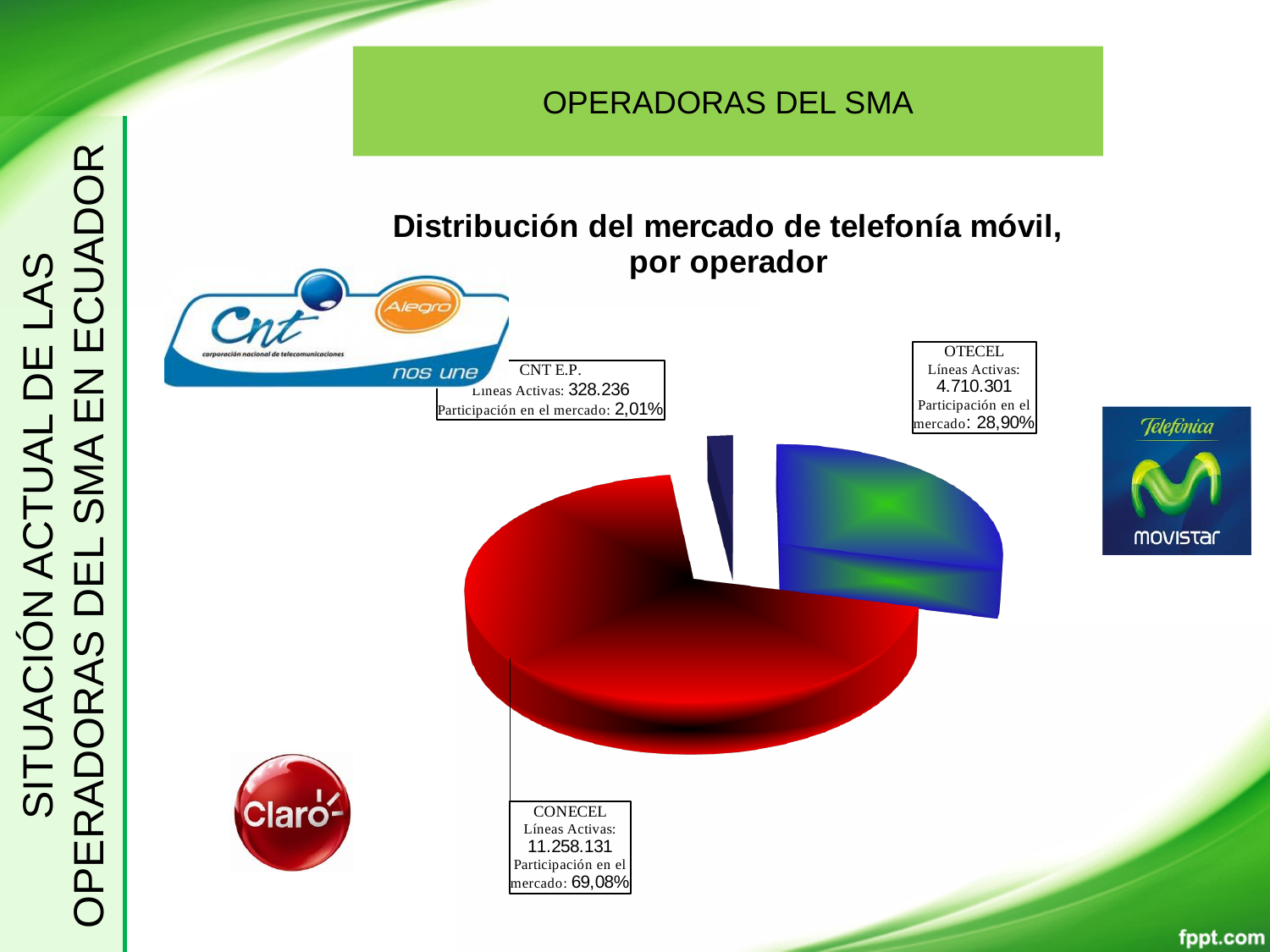
Which operator has the smallest share of the pie? CNT E.P. What is the title of the pie chart? Distribución del mercado de telefonía móvil, por operador How many slices does the pie chart have? 3 How many active lines (Líneas Activas) does OTECEL have? 4.710.301 How many active lines (Líneas Activas) does CNT E.P. have? 328.236 What is the market share (Participación en el mercado) of OTECEL? 28,90% What is the market share (Participación en el mercado) of CONECEL? 69,08% Which operator has more active lines, OTECEL or CNT E.P.? OTECEL What is the market share (Participación en el mercado) of CNT E.P.? 2,01% What kind of chart is shown on the slide? pie chart Which operator has the largest share of the pie? CONECEL How many active lines (Líneas Activas) does CONECEL have? 11.258.131